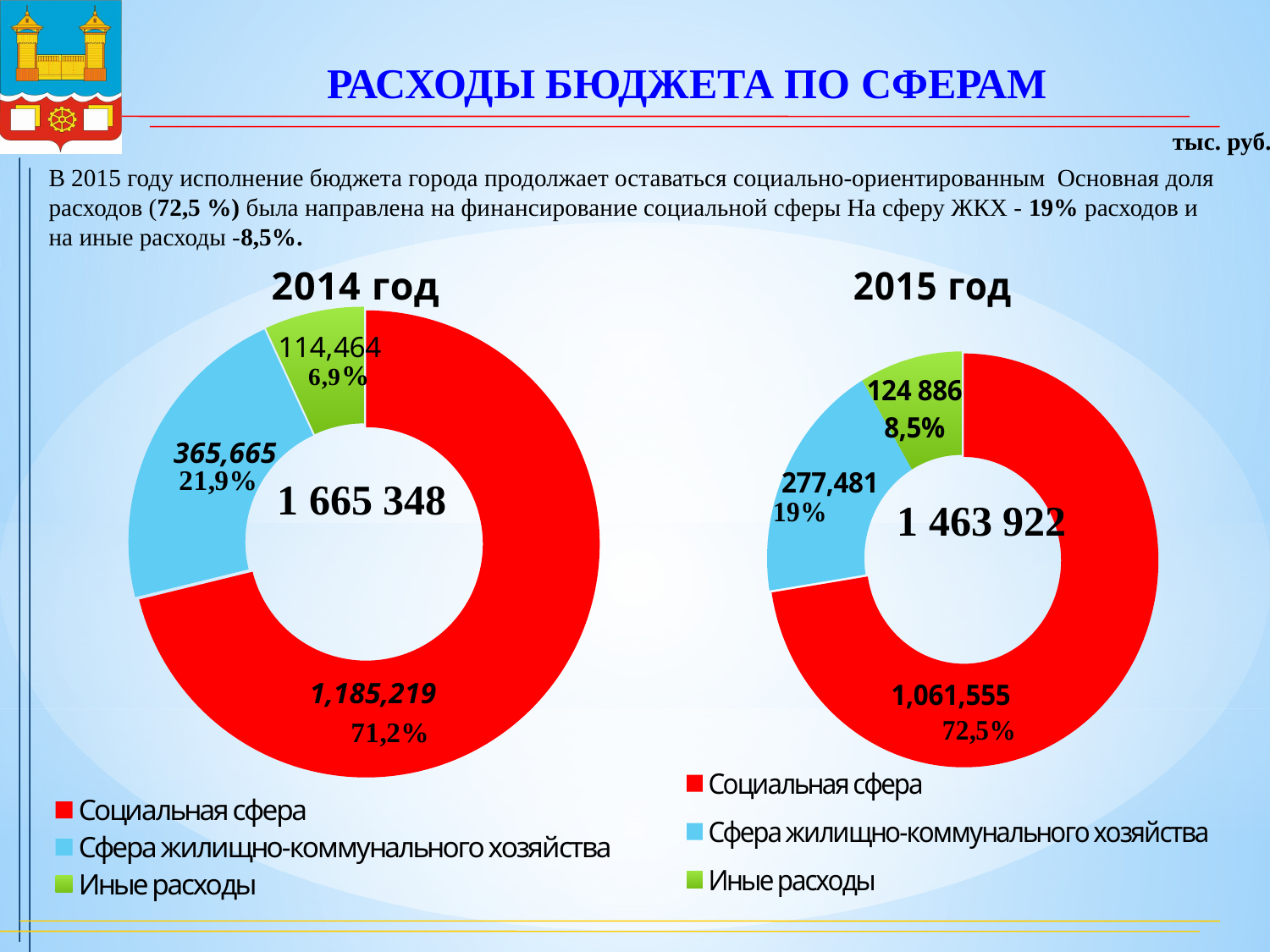
What is the total shown in the centre of the "2014 год" chart? 1 665 348 In the "2014 год" chart, what is the value for Социальная сфера? 1,185,219 Which is larger: Иные расходы in the "2014 год" chart or Иные расходы in the "2015 год" chart? 2015 год What is the total shown in the centre of the "2015 год" chart? 1 463 922 In the "2015 год" chart, which category has the smallest value? Иные расходы In the "2015 год" chart, what is the value for Иные расходы? 124 886 How many categories does the legend of the "2014 год" chart list? 3 In the "2015 год" chart, what is the value for Сфера жилищно-коммунального хозяйства? 277,481 In the "2014 год" chart, what share of the total does Сфера жилищно-коммунального хозяйства represent? 21,9% In the "2015 год" chart, what share of the total does Социальная сфера represent? 72,5% In the "2014 год" chart, which category has the largest value? Социальная сфера What type of chart is the "2015 год" chart? Doughnut chart